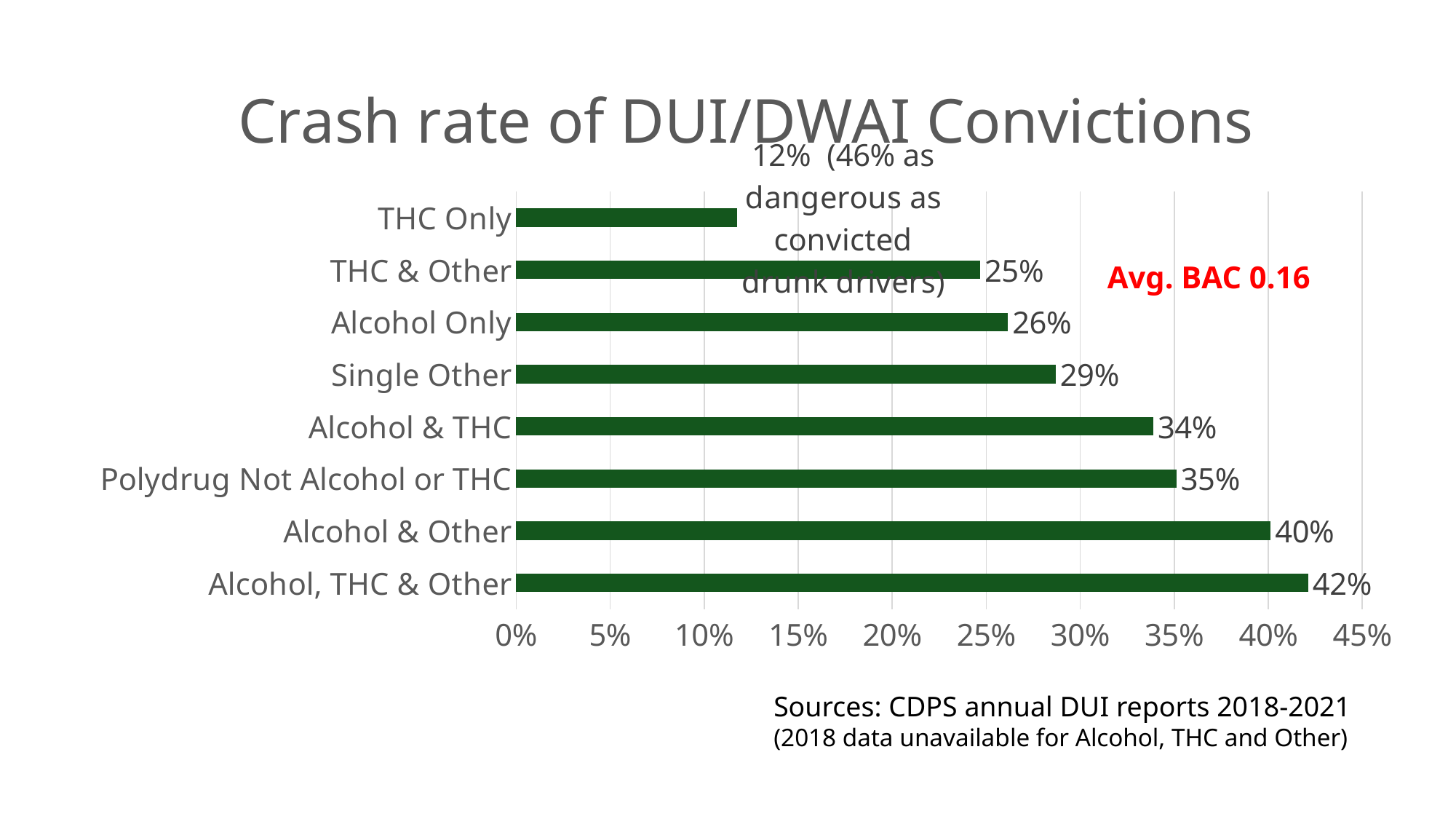
Which has a higher crash rate, Single Other or Alcohol Only? Single Other Which category has the lowest crash rate? THC Only What is the crash rate for Polydrug Not Alcohol or THC? 35% How many categories are shown in the chart? 8 What is the crash rate for THC Only? 12% Which category has the highest crash rate? Alcohol, THC & Other What is the crash rate for Alcohol & THC? 34% What is the difference between the crash rates for Alcohol & Other and THC & Other? 15% What is the title of the chart? Crash rate of DUI/DWAI Convictions What is the crash rate for Alcohol Only? 26% What kind of chart is shown on the slide? Bar chart Is the value for Alcohol, THC & Other greater or less than 40%? greater